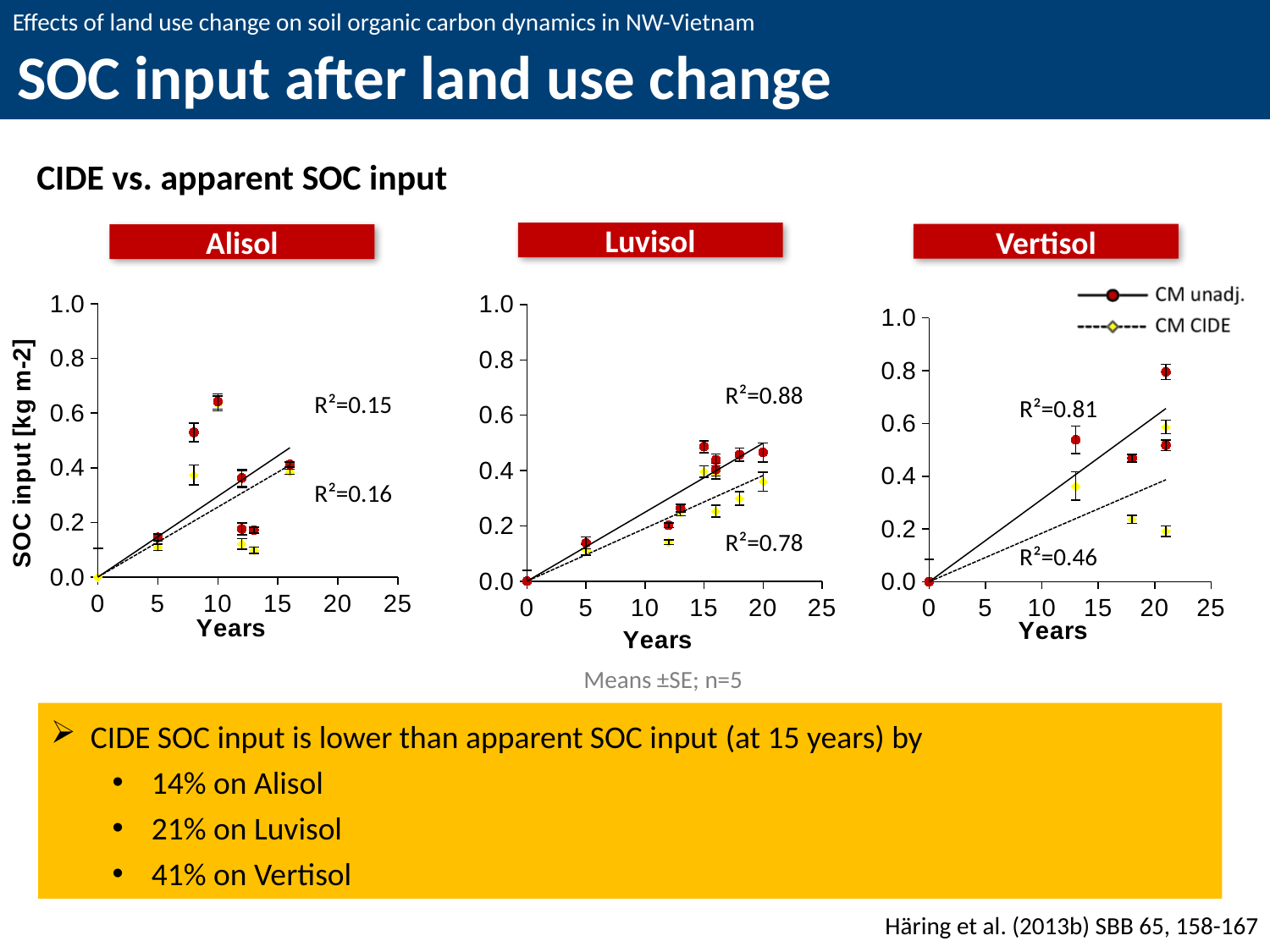
Which of the three charts shows the highest R² for the CM unadj. regression line? Luvisol In the Alisol chart, what is the R² value for the CM unadj. (solid) regression line? R²=0.15 Which is larger: the CM unadj. R² in the Alisol chart or in the Vertisol chart? Vertisol In the Alisol chart, what is the R² value for the CM CIDE (dashed) regression line? R²=0.16 How many charts are shown on the slide? 3 What are the two series named in the legend? CM unadj. and CM CIDE What kind of chart is used for the Alisol panel? scatter chart In the Luvisol chart, do the regression lines rise or fall as years increase? rise How many series does the legend list? 2 In the Vertisol chart, what is the R² value for the CM CIDE regression line? R²=0.46 In the Luvisol chart, what is the R² value for the CM unadj. regression line? R²=0.88